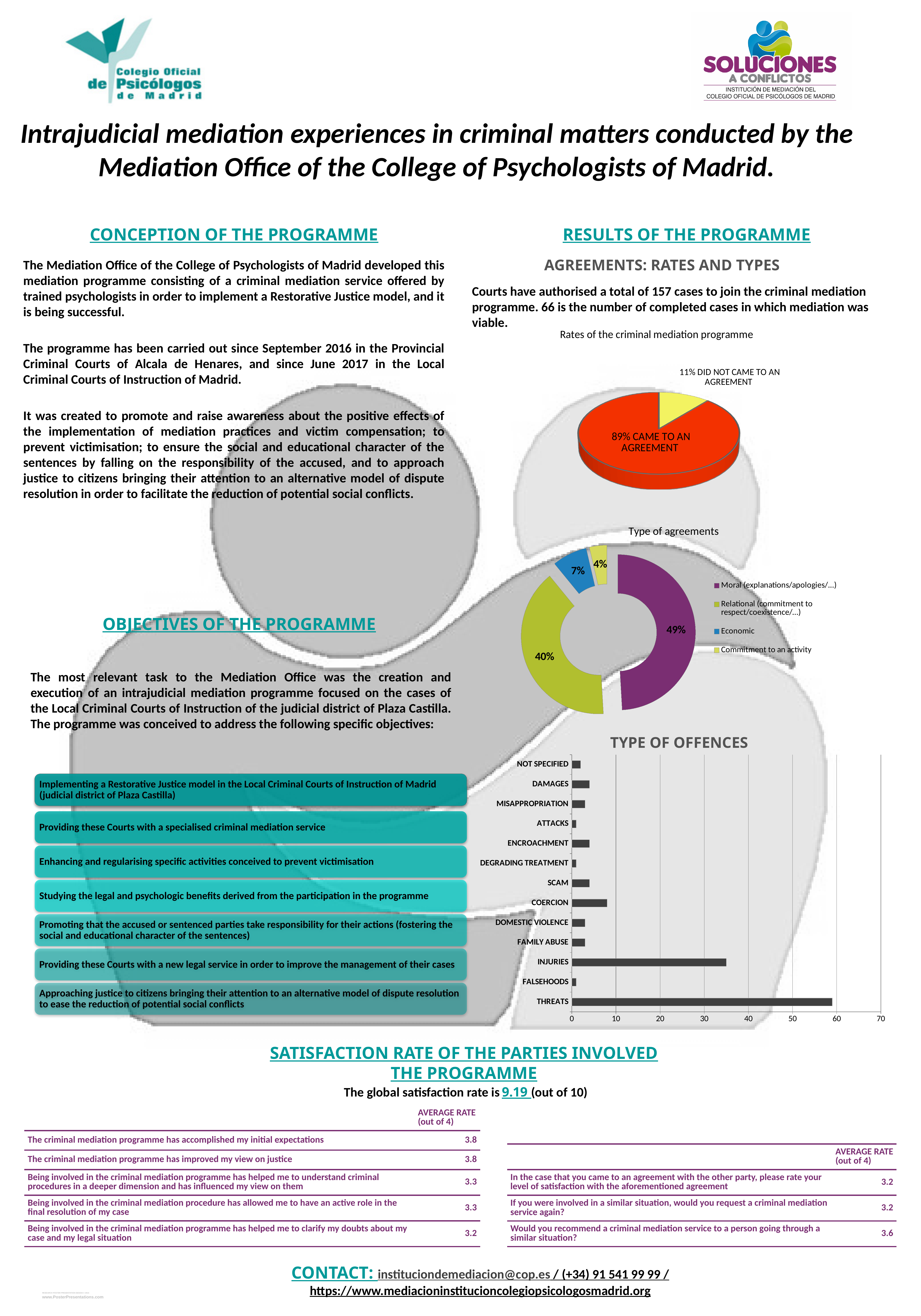
How many entries does the legend of the 'Type of agreements' chart list? 4 In the 'Type of agreements' chart, how many percentage points higher is Moral than Relational? 9% In the 'Rates of the criminal mediation programme' pie chart, what share of cases did not come to an agreement? 11% In the 'TYPE OF OFFENCES' chart, which offence has the highest value? THREATS In the 'Rates of the criminal mediation programme' pie chart, what share of cases came to an agreement? 89% In the 'Type of agreements' chart, which type of agreement has the smallest share? Commitment to an activity In the 'Type of agreements' chart, what percentage is shown for Moral (explanations/apologies/...)? 49% What kind of chart is 'Rates of the criminal mediation programme'? Pie chart In the 'TYPE OF OFFENCES' chart, is the value for INJURIES greater or less than 30? greater How many offence categories are shown in the 'TYPE OF OFFENCES' chart? 13 In the 'Type of agreements' chart, what percentage is shown for Relational (commitment to respect/coexistence/...)? 40% What kind of chart is 'TYPE OF OFFENCES'? Bar chart